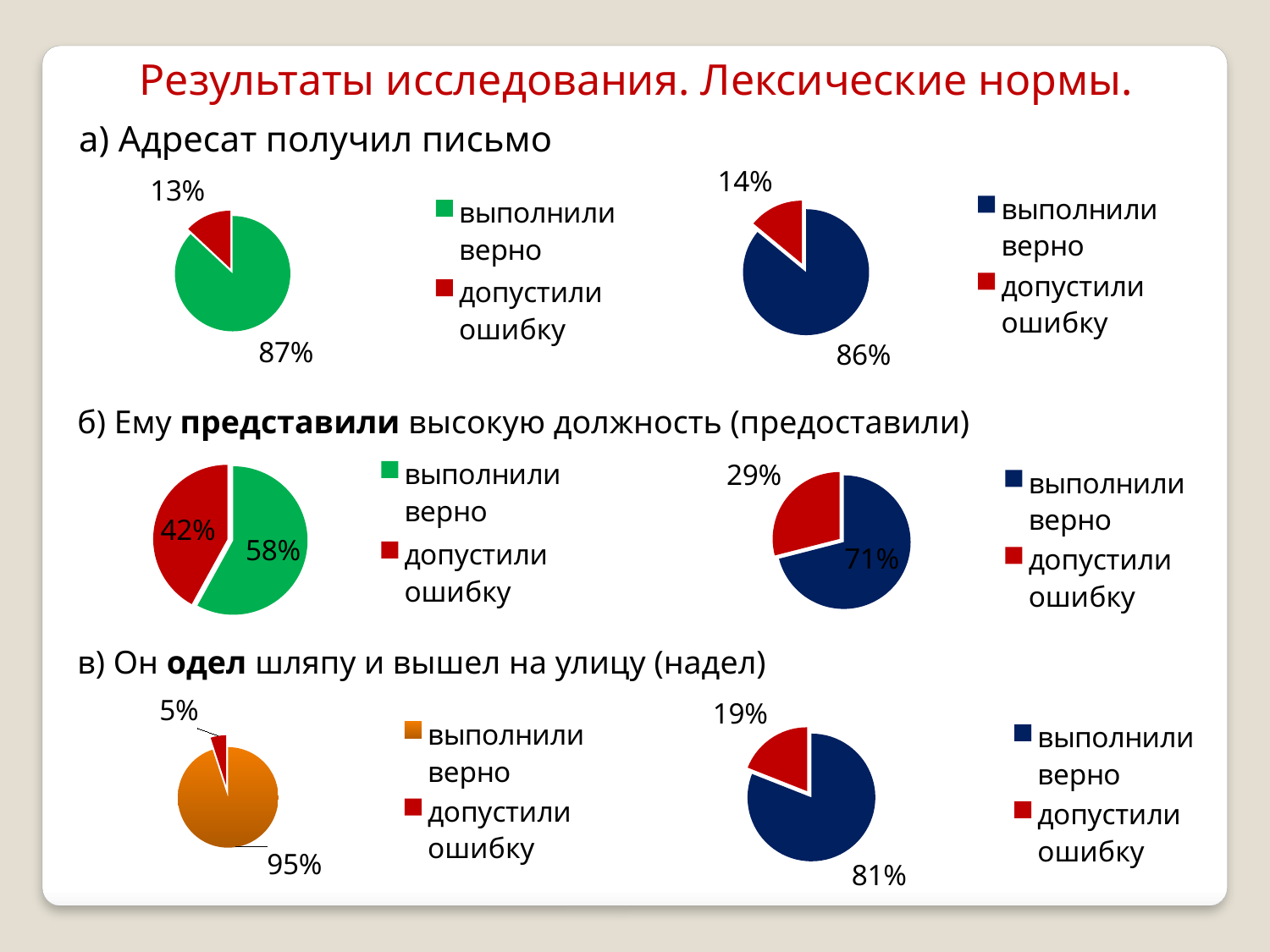
In the left pie chart of row б), which slice is larger: 'выполнили верно' or 'допустили ошибку'? выполнили верно In the left pie chart of row в) (Он одел шляпу), what share is labelled for 'допустили ошибку'? 5% How many series does the legend of the right chart in row б) list? 2 In the left pie chart of row а) (Адресат получил письмо), what share is labelled for 'выполнили верно'? 87% In the left pie chart of row б), what is the difference between the 'выполнили верно' and 'допустили ошибку' shares? 16% In the right pie chart of row а) (Адресат получил письмо), what share is labelled for 'допустили ошибку'? 14% What type of chart is used in row а) on the left? Pie chart In the right pie chart of row в), what is the difference between the 'выполнили верно' and 'допустили ошибку' shares? 62% In the left pie chart of row б) (Ему представили высокую должность), what share is labelled for 'допустили ошибку'? 42% In the right pie chart of row б) (Ему представили высокую должность), what share is labelled for 'выполнили верно'? 71% How many pie charts are shown on the slide in total? 6 In the right pie chart of row в) (Он одел шляпу), what share is labelled for 'выполнили верно'? 81%